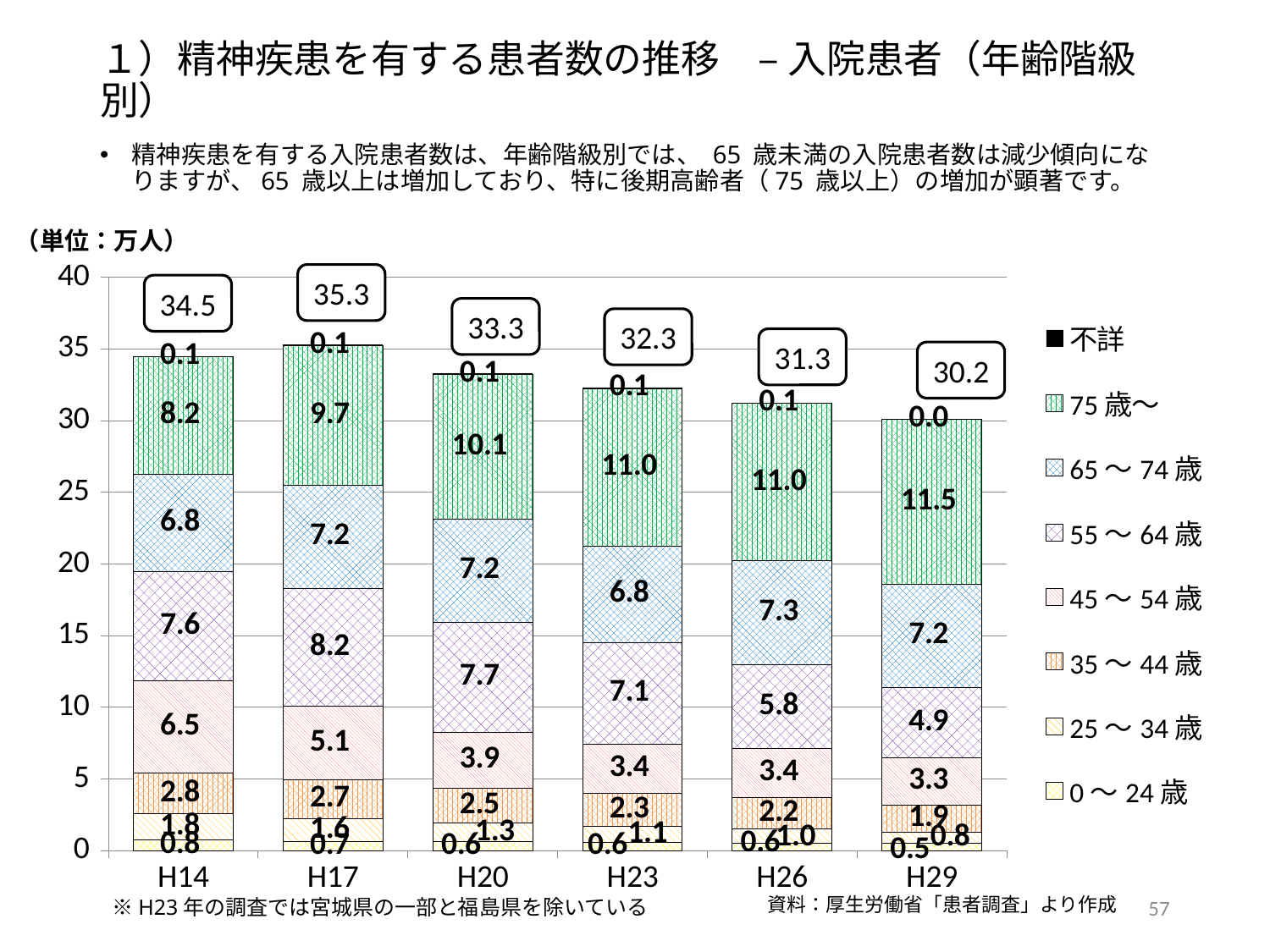
What is the value for the 45～54歳 segment in H14? 6.5 Which year has the highest total value? H17 What is the difference between the total for H14 and the total for H29? 4.3 What is the value for the 75歳～ segment in H29? 11.5 What is the total value shown above the bar for H17? 35.3 How many year categories are shown on the x axis of the chart? 6 What kind of chart is shown on the slide? Stacked bar chart Which year has the lowest total value? H29 What is the value for the 55～64歳 segment in H17? 8.2 How many series does the legend list? 8 Which is larger, the 65～74歳 value in H26 or the 65～74歳 value in H23? H26 Does the 75歳～ segment value rise or fall from H14 to H29? Rise